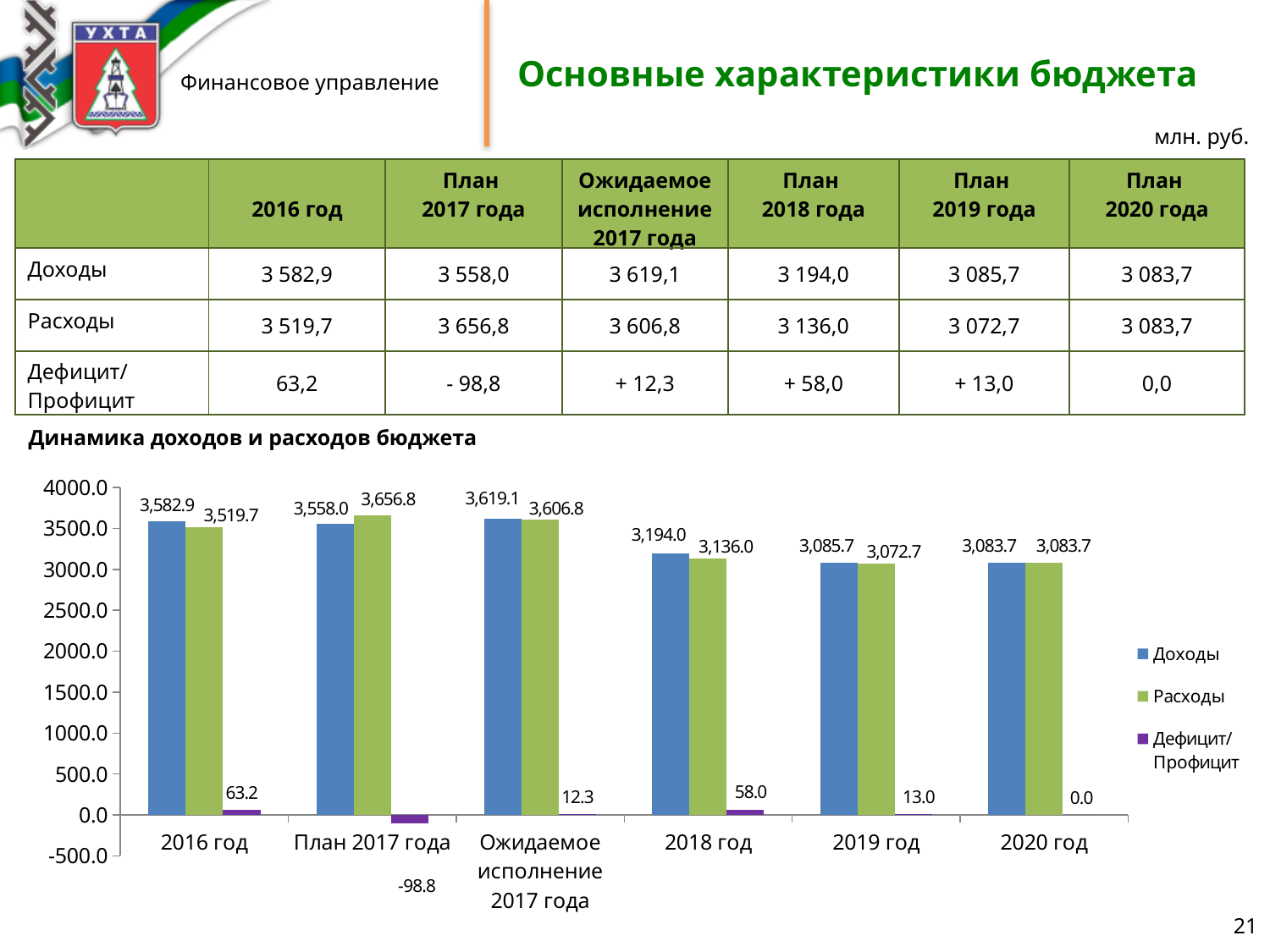
How many categories are shown on the x axis of the chart? 6 What is the value of Дефицит/Профицит for 2018 год in the chart? 58.0 Which category has the highest Расходы value in the chart? План 2017 года What is the value of Доходы for 2016 год in the chart? 3,582.9 What is the value of Расходы for План 2017 года in the chart? 3,656.8 Which category has the lowest Дефицит/Профицит value in the chart? План 2017 года How many series does the chart legend list? 3 Do the Доходы values rise or fall from Ожидаемое исполнение 2017 года to 2020 год? Fall What kind of chart is shown on the slide? Bar chart What is the title of the chart on the slide? Динамика доходов и расходов бюджета For Ожидаемое исполнение 2017 года, which is larger in the chart: Доходы or Расходы? Доходы What is the difference between Доходы and Расходы for 2016 год in the chart? 63.2